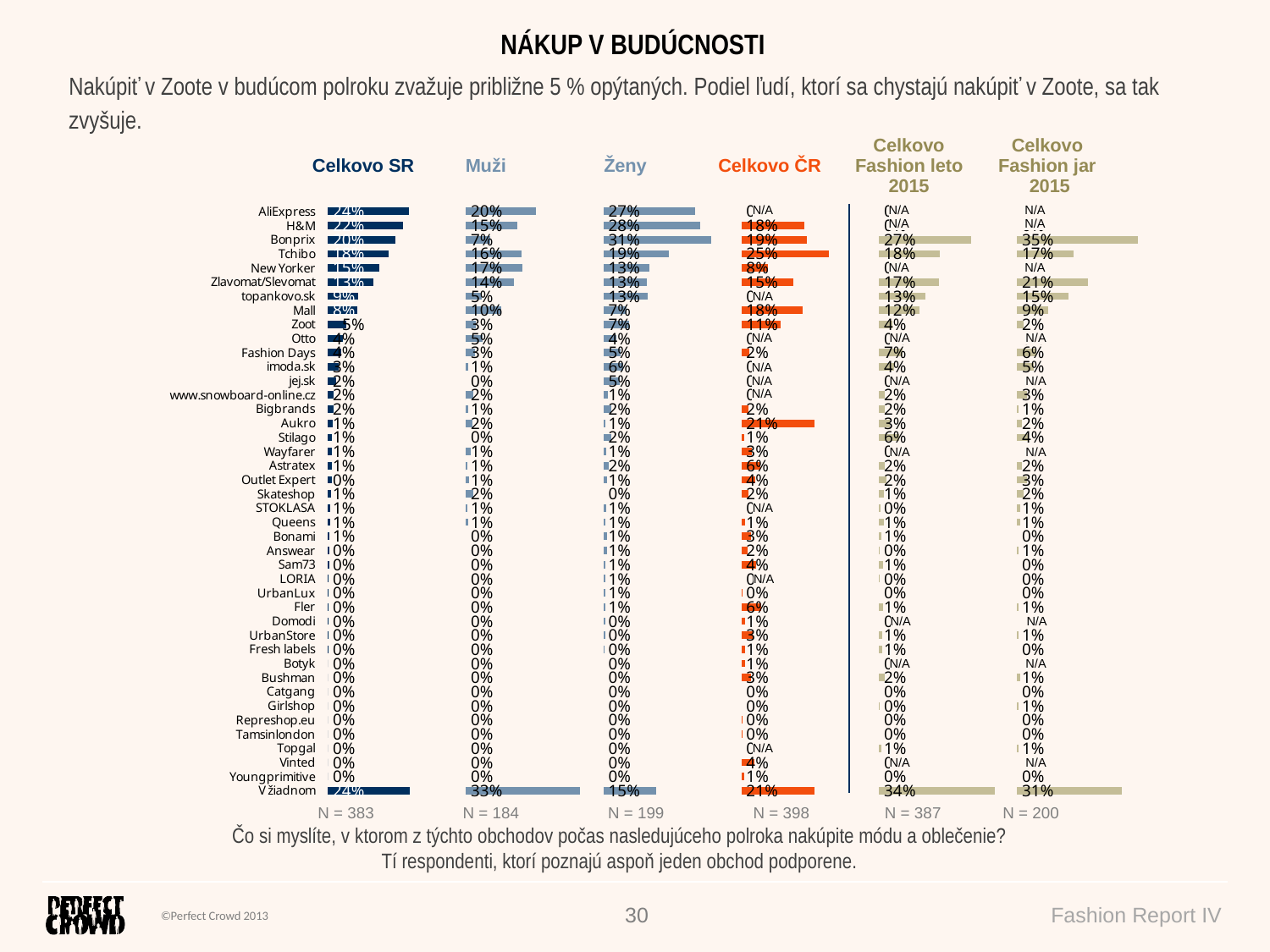
In the Ženy chart, which of the named shops (excluding V žiadnom) has the highest value? Bonprix In the Celkovo ČR chart, what is the value for Tchibo? 25% In the Muži chart, which category has the highest value? V žiadnom In the Ženy chart, what is the difference between H&M and AliExpress? 1% What is the difference between the Zoot value in the Celkovo Fashion leto 2015 chart and the Zoot value in the Celkovo Fashion jar 2015 chart? 2% In the Celkovo ČR chart, which is larger, the value for Aukro or the value for Zoot? Aukro In the Celkovo Fashion jar 2015 chart, what is the value for Bonprix? 35% In the Celkovo SR chart, what is the value for Zoot? 5% In the Ženy chart, what is the value for Bonprix? 31% In the Muži chart, what is the value for AliExpress? 20% What kind of chart is used on this slide? Bar chart In the Celkovo Fashion leto 2015 chart, what is the value for V žiadnom? 34%